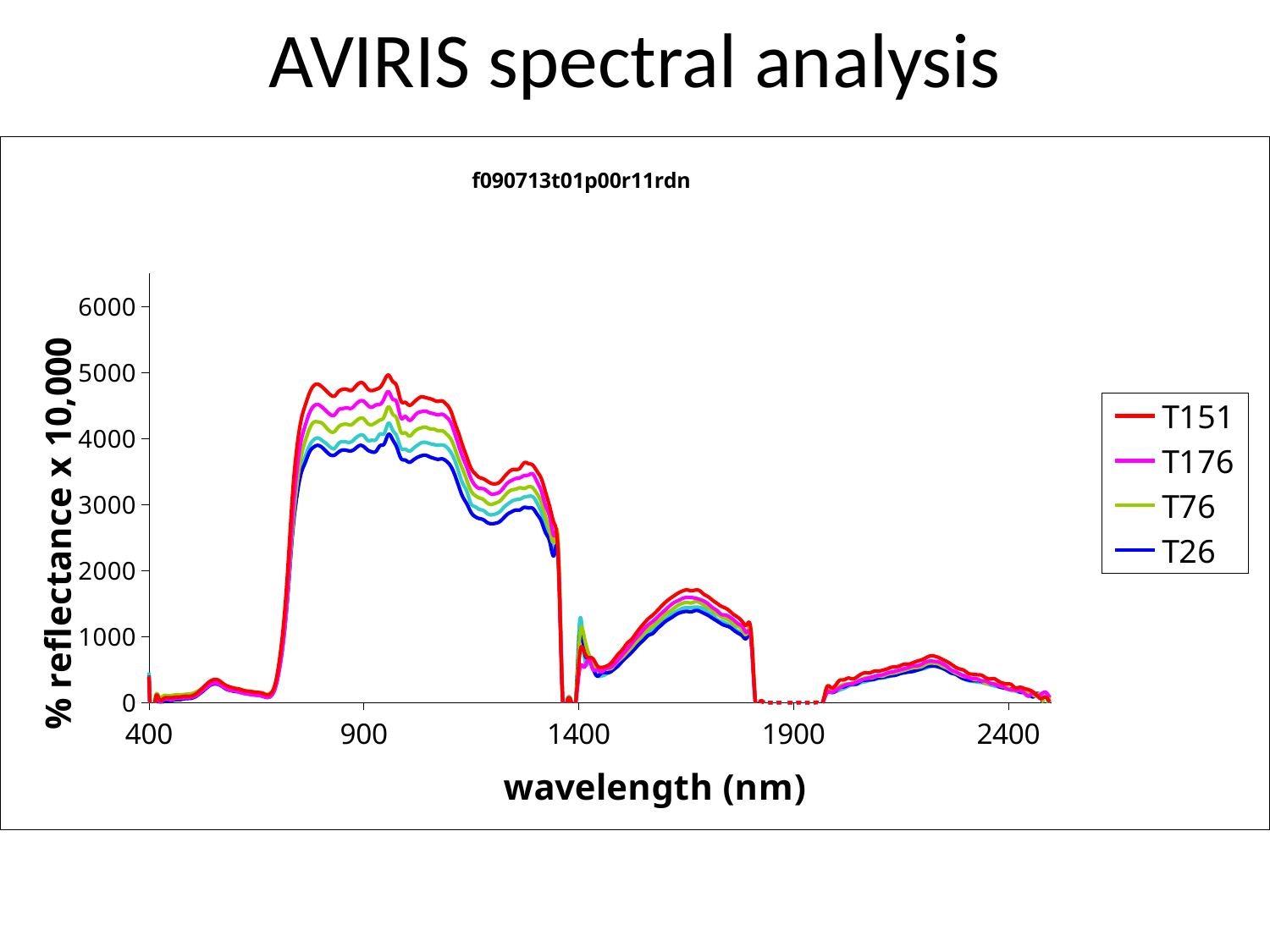
What kind of chart is shown on the slide? line chart What is the title printed above the chart? f090713t01p00r11rdn How many series does the legend list? 4 Is the value for T151 around 1650 nm greater or less than 1000? greater Is the value for T151 around 900 nm greater or less than 4000? greater Do the values rise or fall along the x axis between 1450 nm and 1650 nm? rise Which series has the highest values around 900 nm? T151 Is the value for T151 around 1900 nm greater or less than 1000? less What is the label of the x axis? wavelength (nm) Around 900 nm, which is larger: the value for T151 or the value for T26? T151 Which legend series has the lowest values around 900 nm? T26